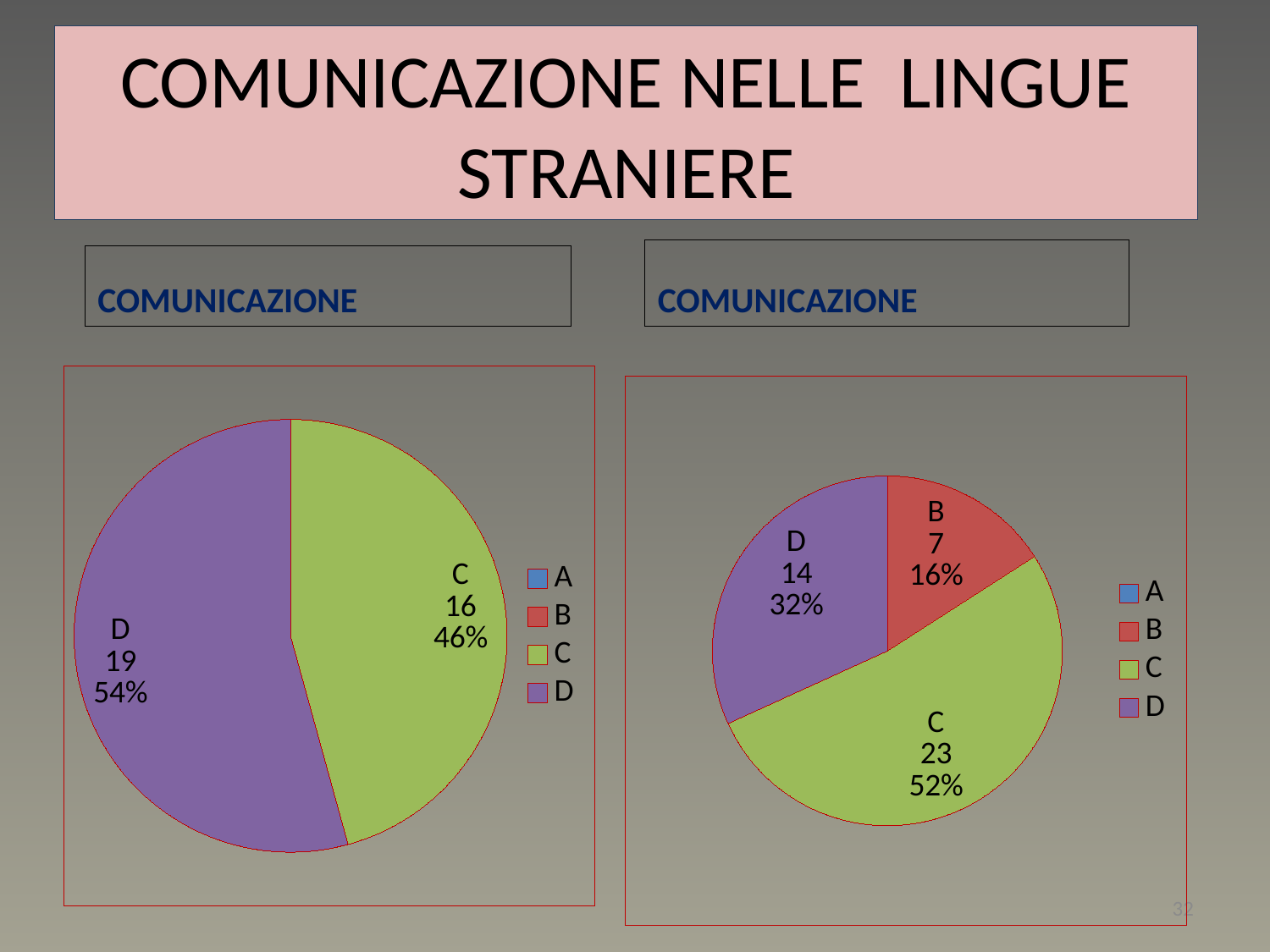
In the left pie chart, what value is shown for category D? 19 How many entries does the legend of the left pie chart list? 4 In the left pie chart, what percentage share does category C have? 46% In the right pie chart, which category has the largest slice? C In the left pie chart, what is the difference between the values for D and C? 3 In the right pie chart, what is the difference between the values for C and D? 9 What type of chart is shown on the right side of the slide? Pie chart In the right pie chart, what value is shown for category B? 7 In the right pie chart, which labelled category has the smallest slice? B In the left pie chart, which category has the largest slice? D In the right pie chart, what percentage share does category D have? 32% In the right pie chart, which is larger, the value for D or the value for B? D